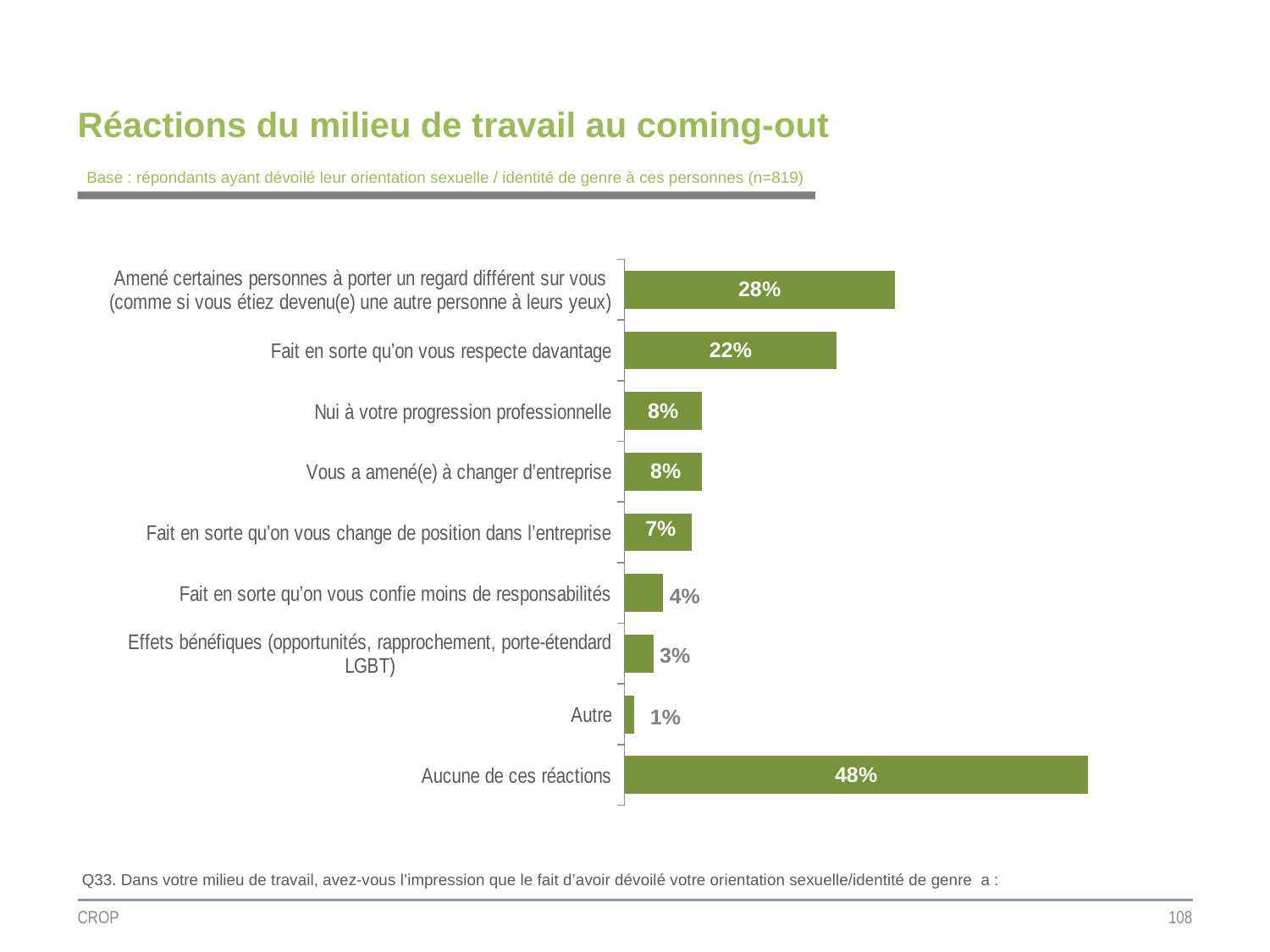
What value is shown for "Effets bénéfiques (opportunités, rapprochement, porte-étendard LGBT)"? 3% What is the difference between the values for "Fait en sorte qu'on vous respecte davantage" and "Fait en sorte qu'on vous change de position dans l'entreprise"? 15% What value is shown for "Aucune de ces réactions"? 48% Which category has the lowest value? Autre What is the title of the slide? Réactions du milieu de travail au coming-out What type of chart is shown on the slide? Bar chart Which is larger: the value for "Fait en sorte qu'on vous confie moins de responsabilités" or the value for "Vous a amené(e) à changer d'entreprise"? Vous a amené(e) à changer d'entreprise What value is shown for "Fait en sorte qu'on vous respecte davantage"? 22% What value is shown for "Nui à votre progression professionnelle"? 8% Which category has the highest value? Aucune de ces réactions What is the difference between the values for "Aucune de ces réactions" and "Amené certaines personnes à porter un regard différent sur vous"? 20% How many categories are shown in the chart? 9